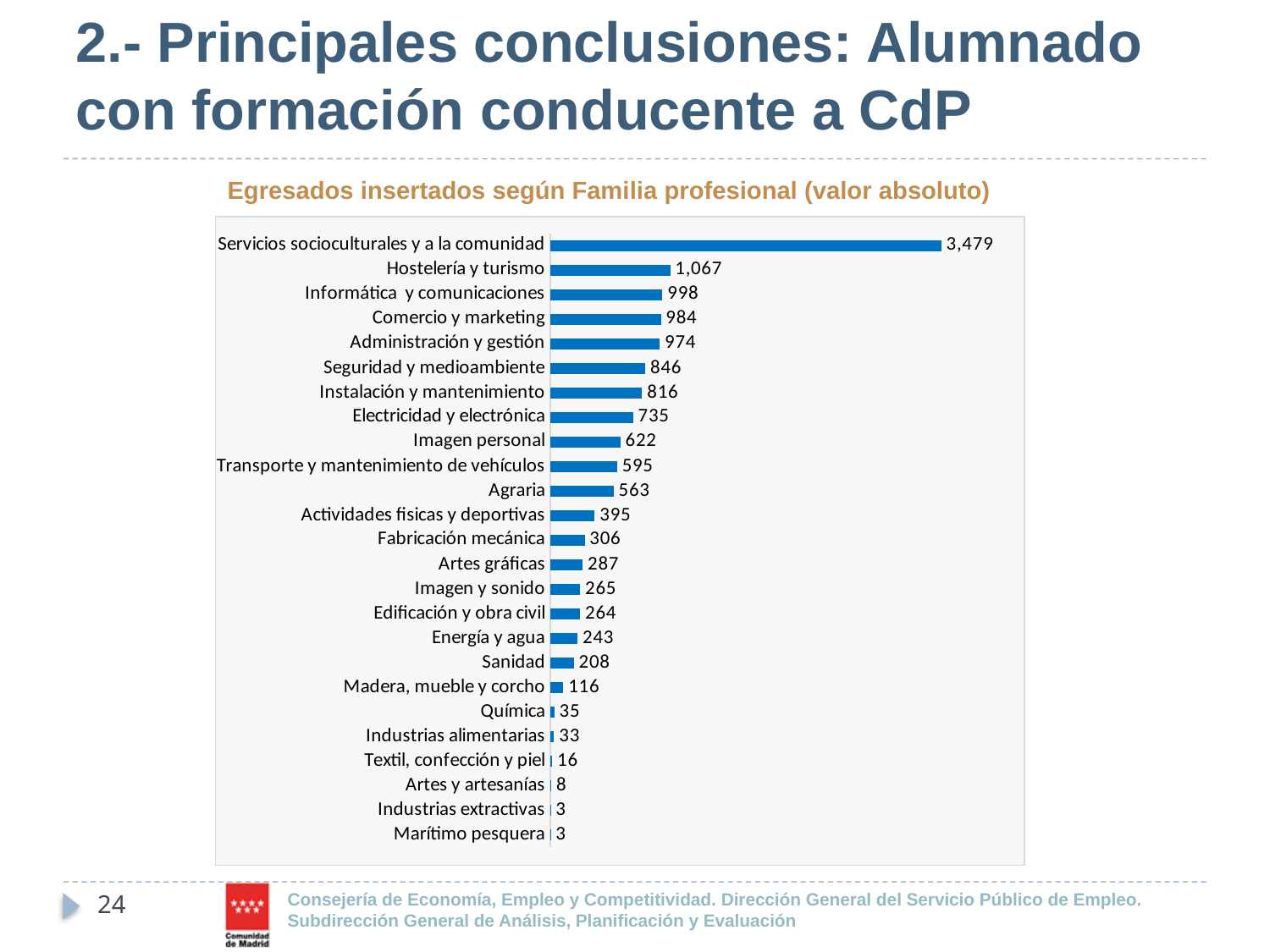
What is the value for Madera, mueble y corcho? 116 How many professional families are shown in the chart? 25 Which is larger, Agraria or Actividades fisicas y deportivas? Agraria What is the value for Hostelería y turismo? 1,067 What is the value for Química? 35 What is the value for Imagen personal? 622 Which professional family has the highest value? Servicios socioculturales y a la comunidad What is the difference between Seguridad y medioambiente and Instalación y mantenimiento? 30 What kind of chart is shown on the slide? Bar chart What is the title of the chart? Egresados insertados según Familia profesional (valor absoluto) Which is larger, Sanidad or Energía y agua? Energía y agua What is the difference between Servicios socioculturales y a la comunidad and Hostelería y turismo? 2,412